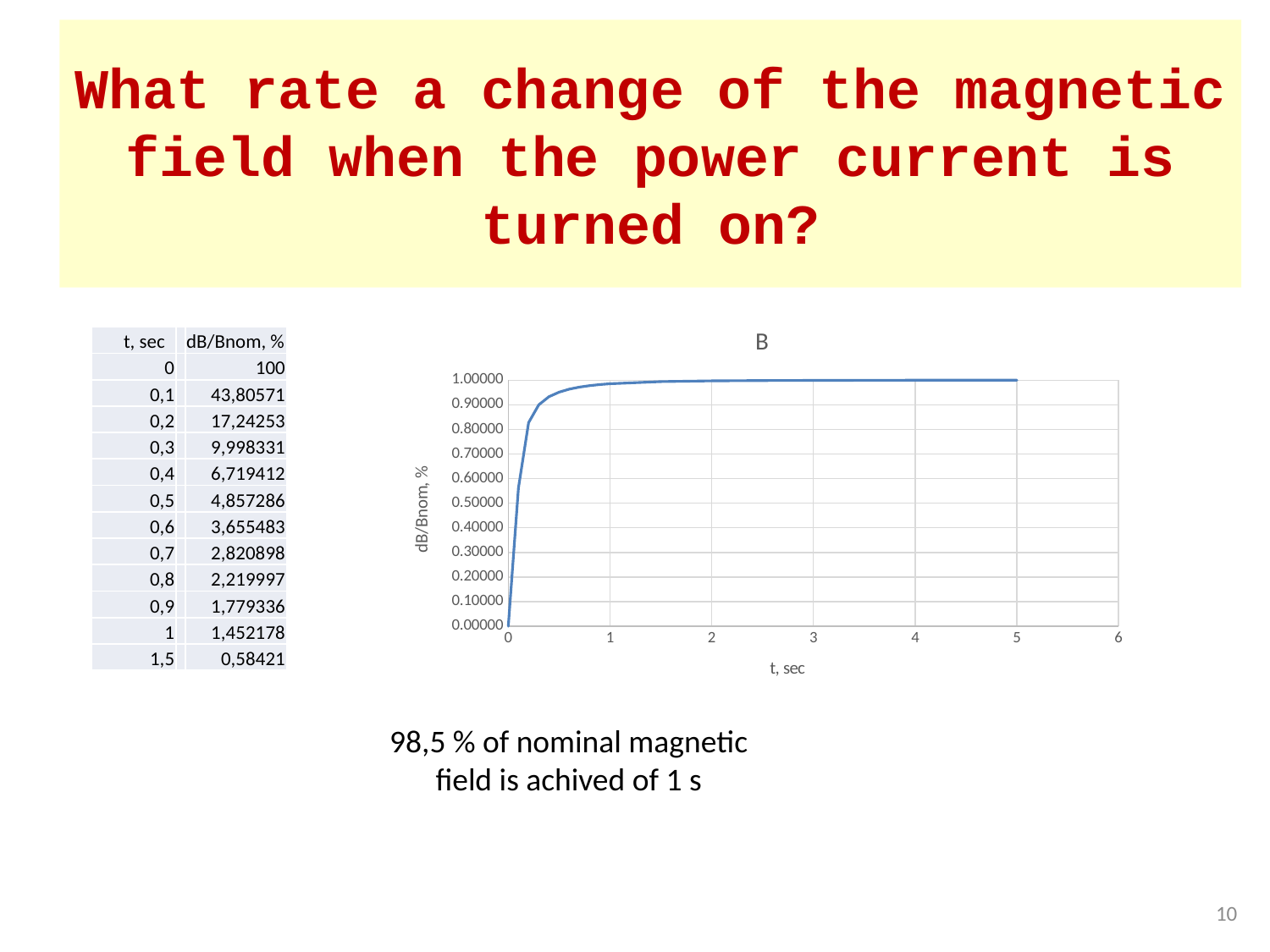
What is the label of the chart's vertical axis? dB/Bnom, % How many lines are plotted on the chart? 1 Does the plotted line rise or fall as t increases from 0 to 1 sec? rises What kind of chart is shown on the slide? line chart Is the value of the line at t = 0.5 greater or less than 0.80000? greater Is the value of the line at t = 3 greater or less than 0.90000? greater Is the value of the line at t = 4 greater or less than 0.50000? greater What is the highest tick value shown on the vertical axis? 1.00000 At what value of t on the horizontal axis does the plotted line end? 5 What is the title of the chart? B